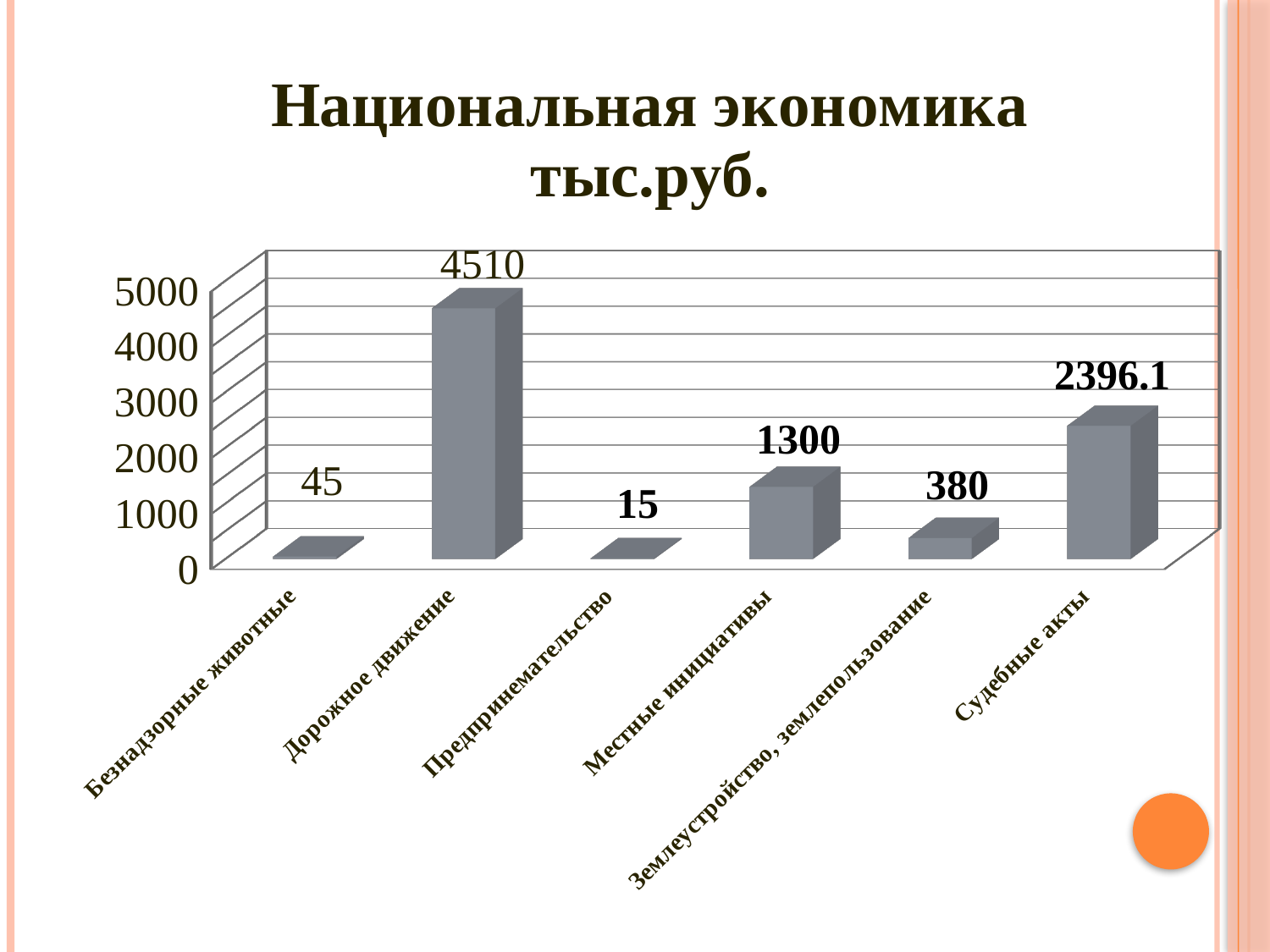
What is the value for Местные инициативы? 1300 What is the difference between the values for Дорожное движение and Судебные акты? 2113.9 What is the value for Дорожное движение? 4510 Which category has the highest value? Дорожное движение What is the title of the chart? Национальная экономика тыс.руб. How many categories are shown on the chart? 6 What is the difference between the values for Местные инициативы and Землеустройство, землепользование? 920 What is the value for Землеустройство, землепользование? 380 Which is larger, the value for Безнадзорные животные or the value for Предпринемательство? Безнадзорные животные What kind of chart is shown on the slide? bar chart Which category has the lowest value? Предпринемательство What is the value for Судебные акты? 2396.1